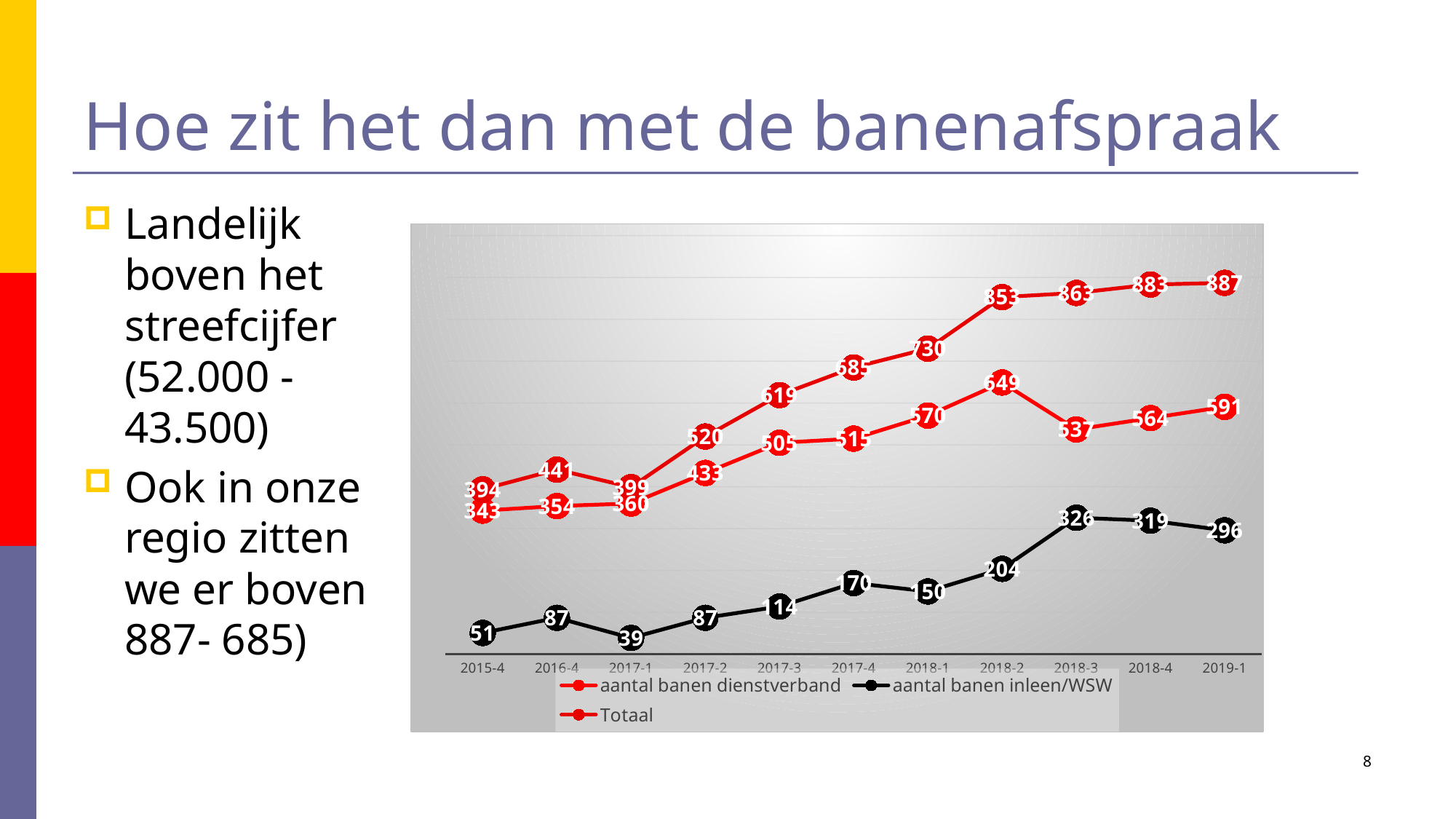
For 'aantal banen dienstverband', which period has the larger value: 2018-2 or 2018-3? 2018-2 What is the value of 'aantal banen inleen/WSW' at 2018-3? 326 What kind of chart is shown on the slide? line chart By how much did the Totaal series increase from 2015-4 to 2019-1? 493 What is the value of the Totaal series at 2019-1? 887 What colour is the line for 'aantal banen inleen/WSW'? black What is the value of 'aantal banen dienstverband' at 2018-2? 649 In which period is 'aantal banen inleen/WSW' at its lowest? 2017-1 How many series does the chart's legend list? 3 How many periods are shown along the x axis of the chart? 11 In which period does the Totaal series reach its highest value? 2019-1 Does the Totaal series generally rise or fall from 2015-4 to 2019-1? rise